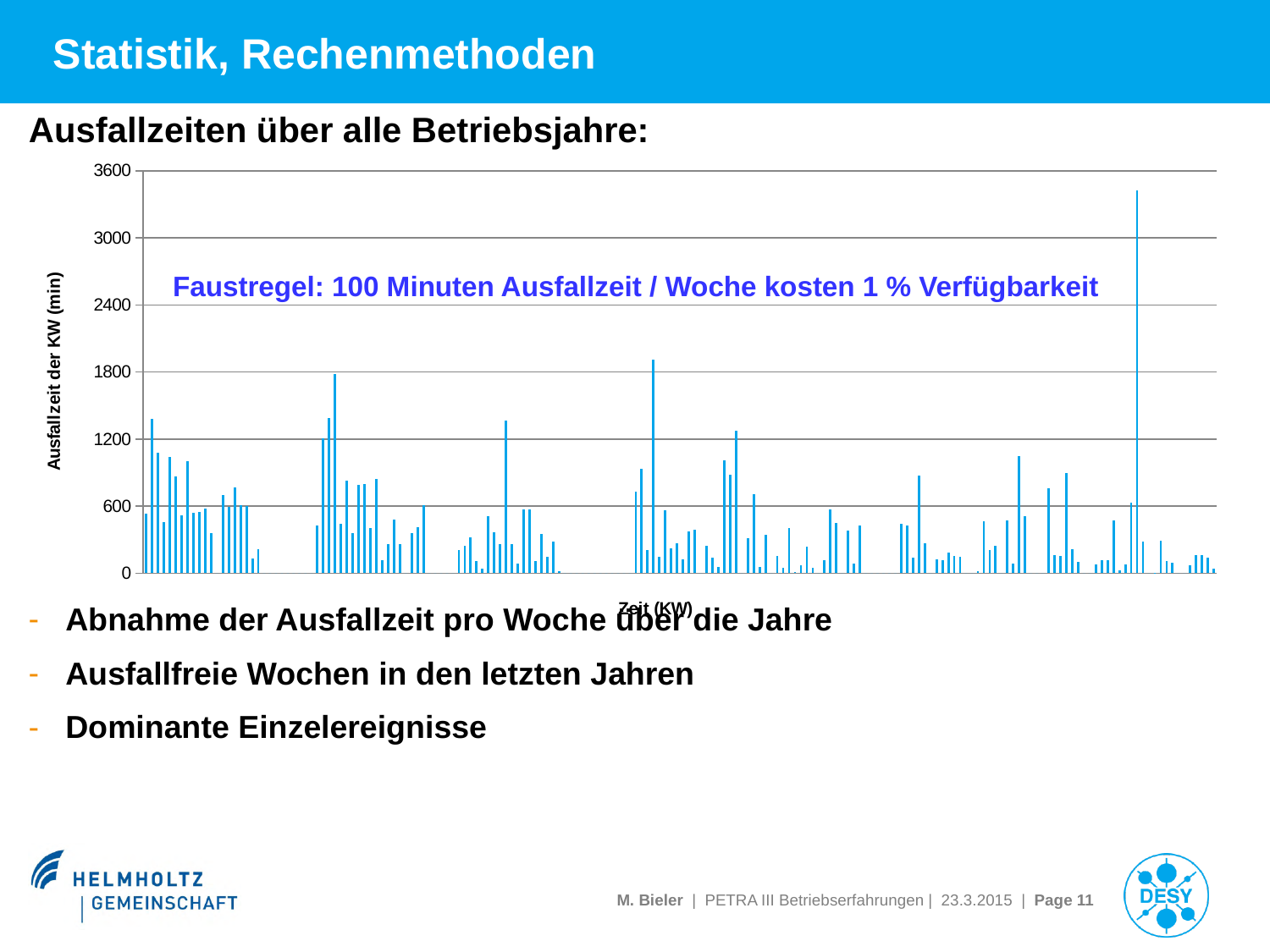
Is the value of the tallest bar in the chart greater or less than 3000? greater Do the bar values in the chart generally rise or fall from left to right along the x axis? fall Is the value of the second-tallest bar in the chart greater or less than 1800? greater Is the value of the tallest bar in the chart greater or less than 3600? less What is the title of the horizontal axis of the chart? Zeit (KW) What is the title of the vertical axis of the chart? Ausfallzeit der KW (min) What kind of chart is shown on the slide? bar chart